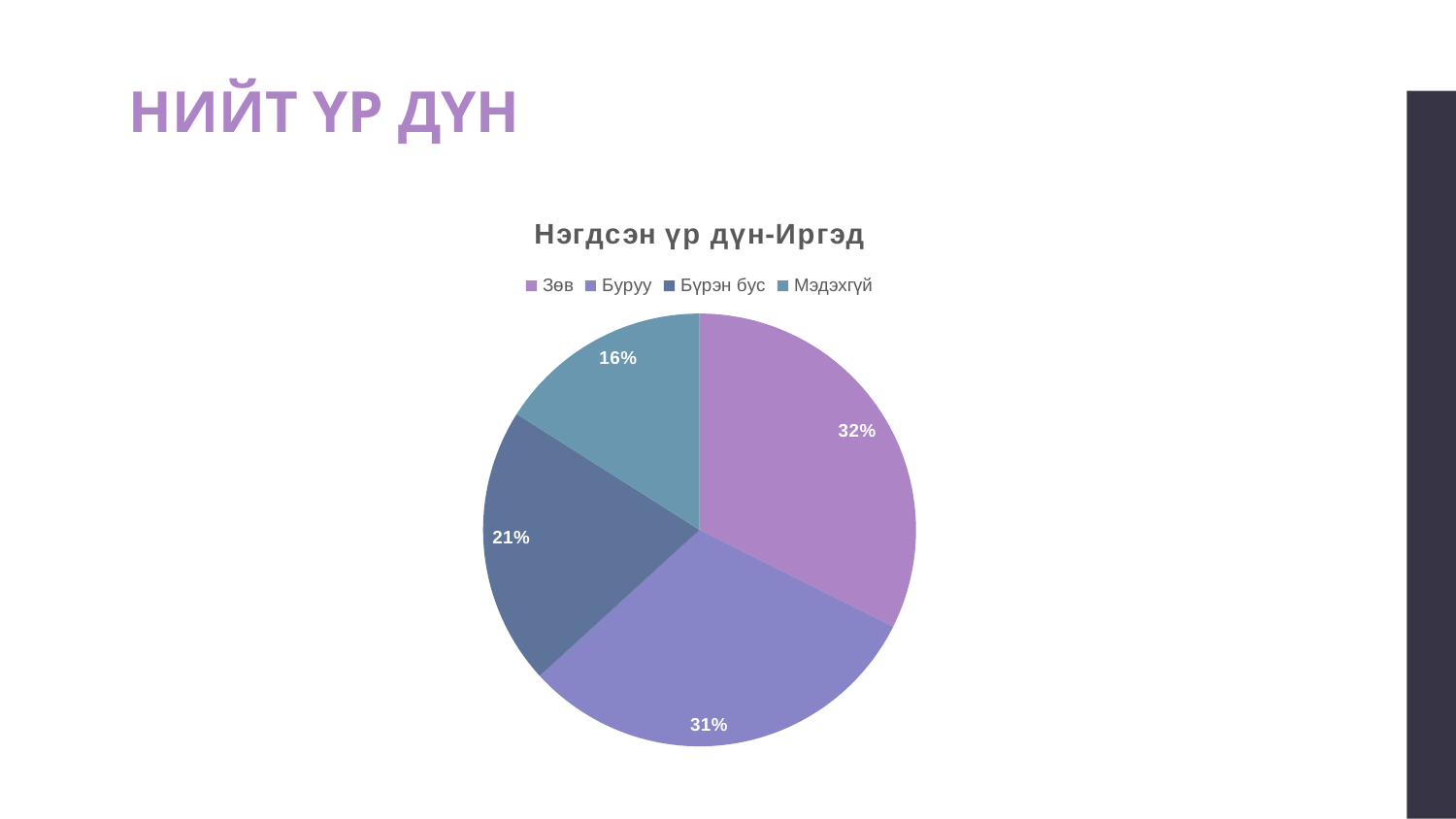
Which category has the largest slice in the pie chart? Зөв What is the title of the chart on the slide? Нэгдсэн үр дүн-Иргэд Which category has the smallest slice in the pie chart? Мэдэхгүй What is the value shown for Бүрэн бус in the pie chart? 21% What is the difference in percentage points between the Зөв and Мэдэхгүй slices? 16 What is the difference in percentage points between the Буруу and Бүрэн бус slices? 10 What share does the Буруу slice have in the pie chart? 31% How many slices does the pie chart have? 4 Which slice is larger, Бүрэн бус or Мэдэхгүй? Бүрэн бус What type of chart is shown on the slide? Pie chart What percentage is shown for Мэдэхгүй in the pie chart? 16% What percentage of the pie chart is labelled Зөв? 32%